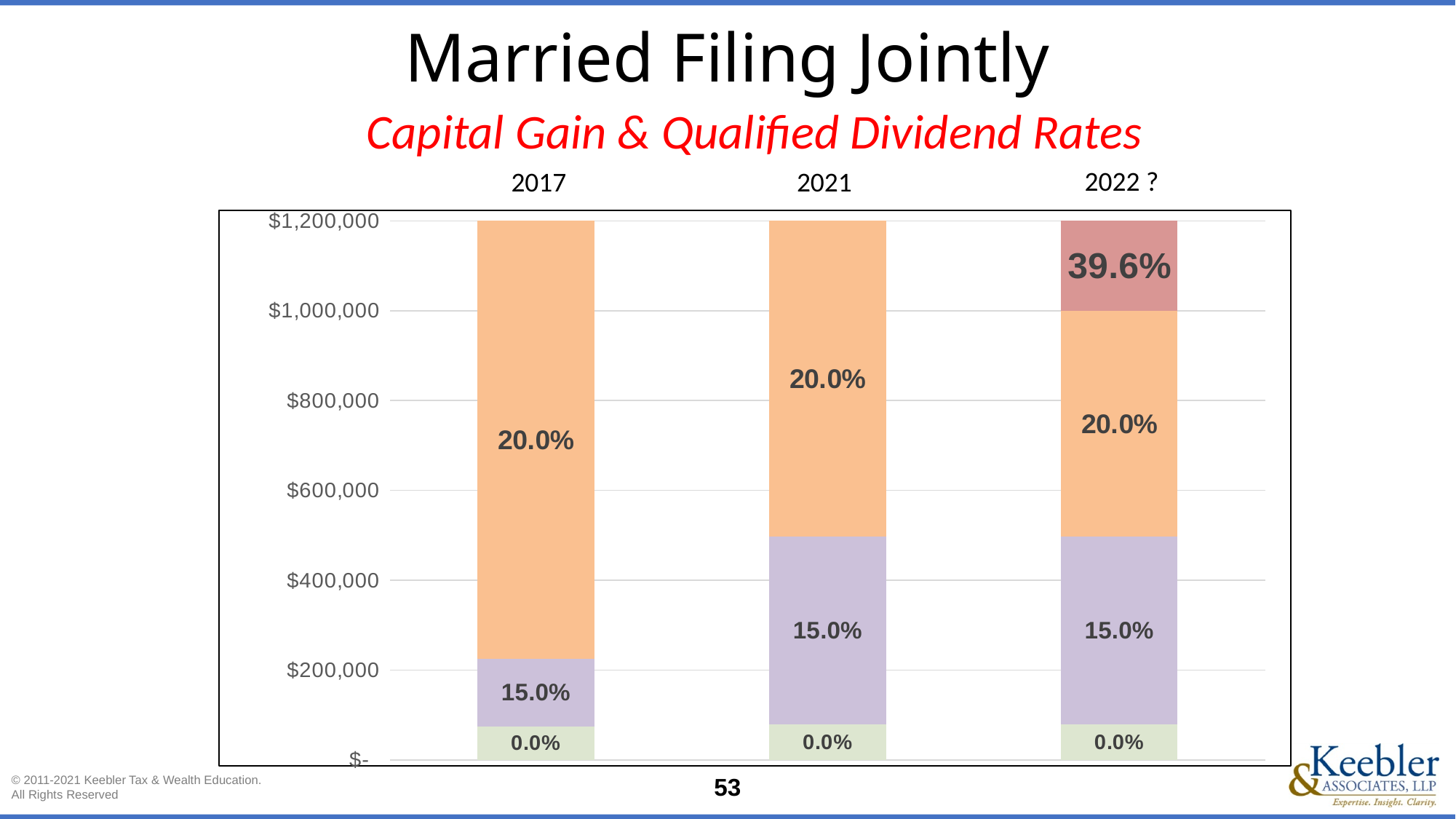
Which year's bar includes a 39.6% segment? 2022 ? Is the top of the 15.0% segment in the 2021 bar greater or less than $400,000? greater Is the top of the 15.0% segment in the 2017 bar greater or less than $400,000? less What kind of chart is shown on the slide? Stacked bar chart What is the red subtitle of the chart on the slide? Capital Gain & Qualified Dividend Rates At what income level on the y-axis does the 39.6% segment of the 2022 ? bar begin? $1,000,000 How many rate segments does the 2017 bar contain? 3 What rate is labeled on the topmost segment of the 2022 ? bar? 39.6% How many bars (years) are plotted in the chart? 3 How many rate segments does the 2022 ? bar contain? 4 What rate is labeled on the bottom segment of each bar? 0.0% What is the highest value shown on the y-axis? $1,200,000